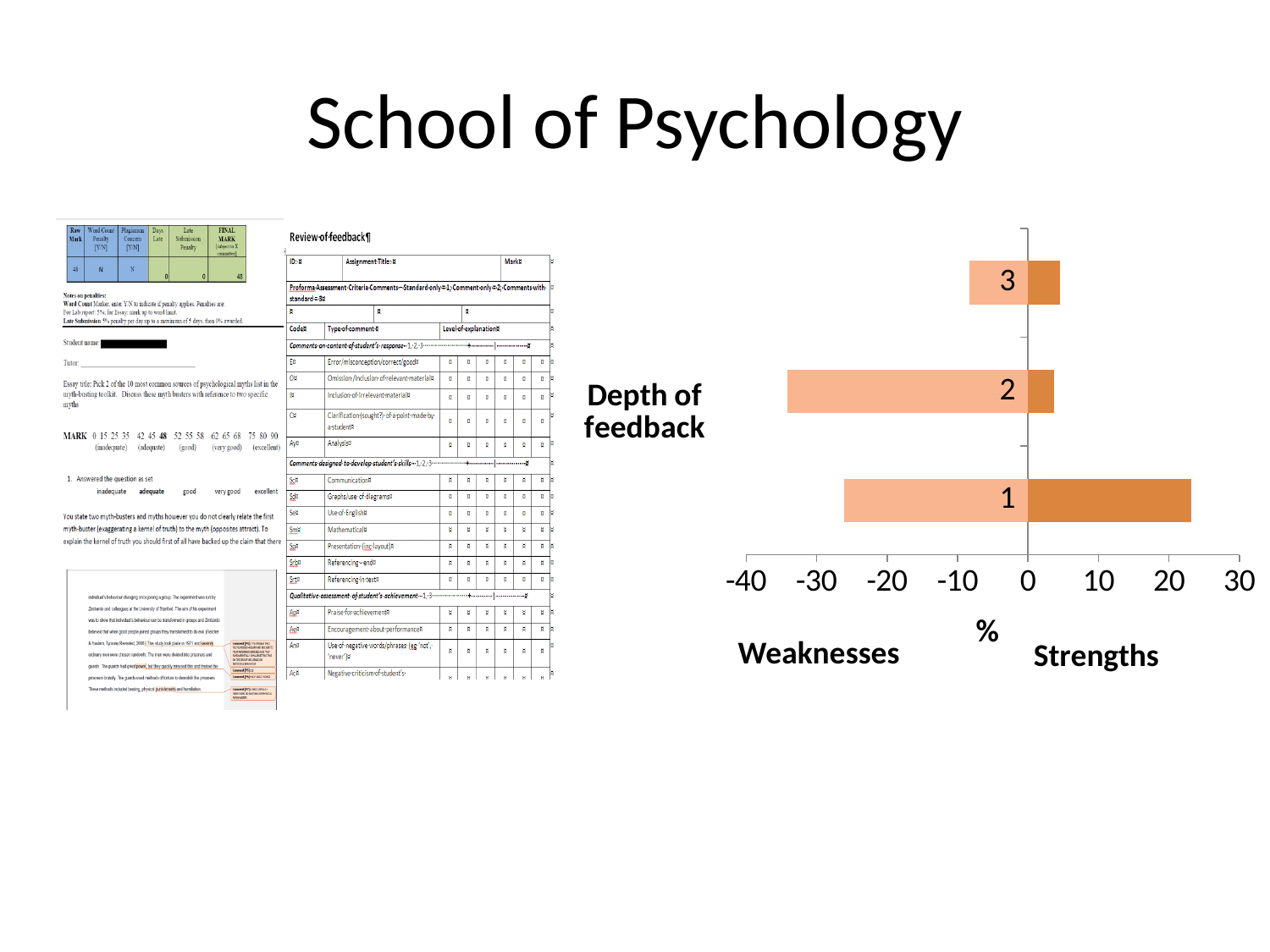
Is the Weaknesses value for category 1 greater or less than -20? less Which depth-of-feedback category has the largest Strengths bar? 1 Which depth-of-feedback category has the shortest Weaknesses bar? 3 Is the Weaknesses value for category 2 greater or less than -30? less Is the Strengths value for category 1 greater or less than 20? greater How many depth-of-feedback categories are plotted in the chart? 3 Which depth-of-feedback category has the longest Weaknesses bar? 2 What label is shown on the x axis of the chart? % Which has the larger Strengths bar, category 1 or category 2? 1 What title is shown to the left of the chart? Depth of feedback What kind of chart is shown on the slide? bar chart